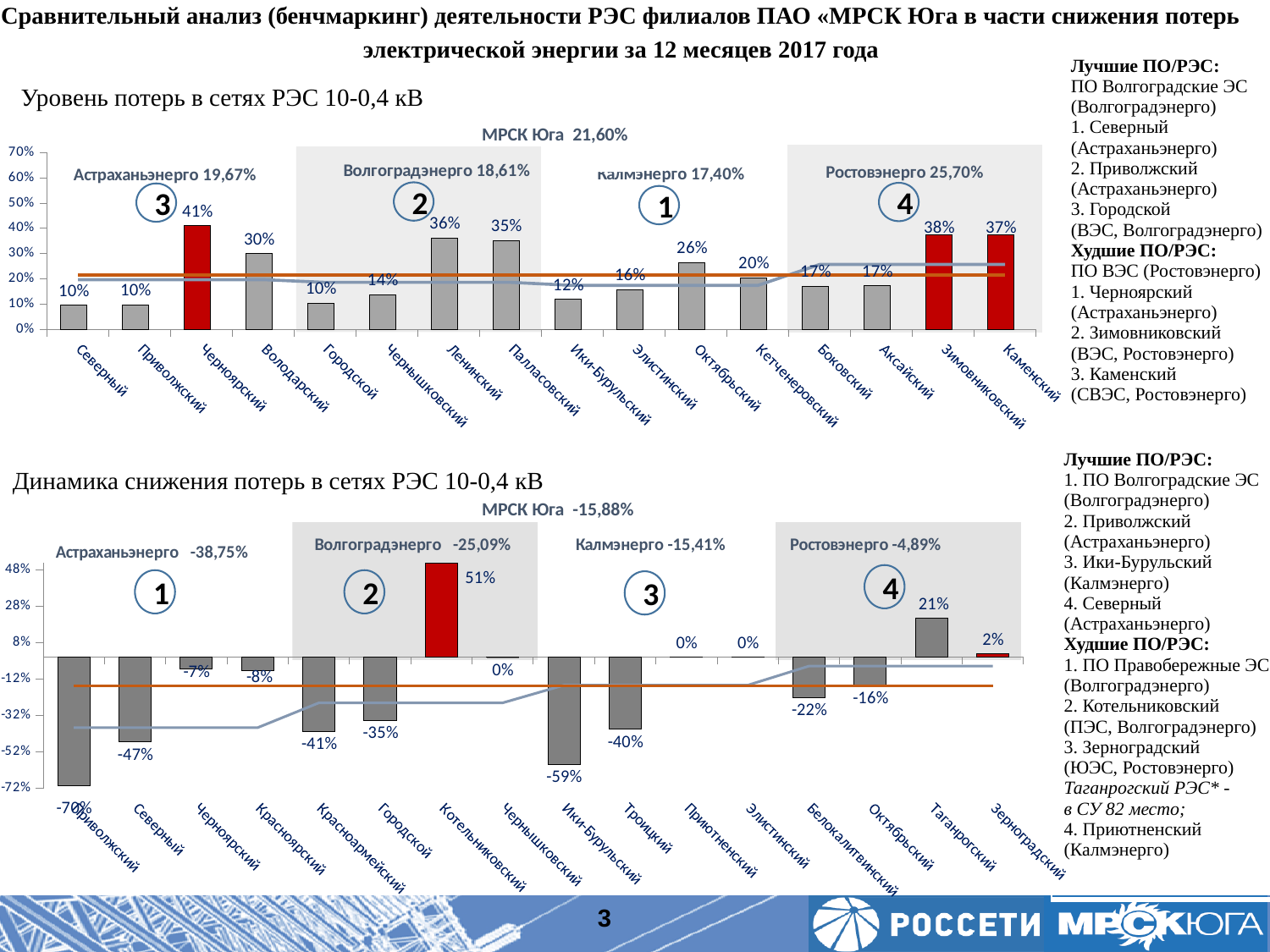
In the top chart 'Уровень потерь в сетях РЭС 10-0,4 кВ', which is larger, the value for Володарский or the value for Октябрьский? Володарский In the top chart 'Уровень потерь в сетях РЭС 10-0,4 кВ', what is the value for Черноярский? 41% In the bottom chart 'Динамика снижения потерь в сетях РЭС 10-0,4 кВ', which category has the lowest value? Приволжский In the top chart 'Уровень потерь в сетях РЭС 10-0,4 кВ', how many categories are shown on the x axis? 16 In the bottom chart 'Динамика снижения потерь в сетях РЭС 10-0,4 кВ', what is the value for Ики-Бурульский? -59% In the top chart 'Уровень потерь в сетях РЭС 10-0,4 кВ', what is the value for Ленинский? 36% In the top chart 'Уровень потерь в сетях РЭС 10-0,4 кВ', what is the difference between the values for Зимовниковский and Каменский? 1% In the bottom chart 'Динамика снижения потерь в сетях РЭС 10-0,4 кВ', what is the difference between the values for Северный and Октябрьский? 31% In the bottom chart 'Динамика снижения потерь в сетях РЭС 10-0,4 кВ', what is the value for Котельниковский? 51% In the top chart 'Уровень потерь в сетях РЭС 10-0,4 кВ', which category has the highest value? Черноярский What kind of chart is the bottom chart 'Динамика снижения потерь в сетях РЭС 10-0,4 кВ'? Combination bar and line chart In the top chart 'Уровень потерь в сетях РЭС 10-0,4 кВ', what value is given for МРСК Юга overall? 21,60%